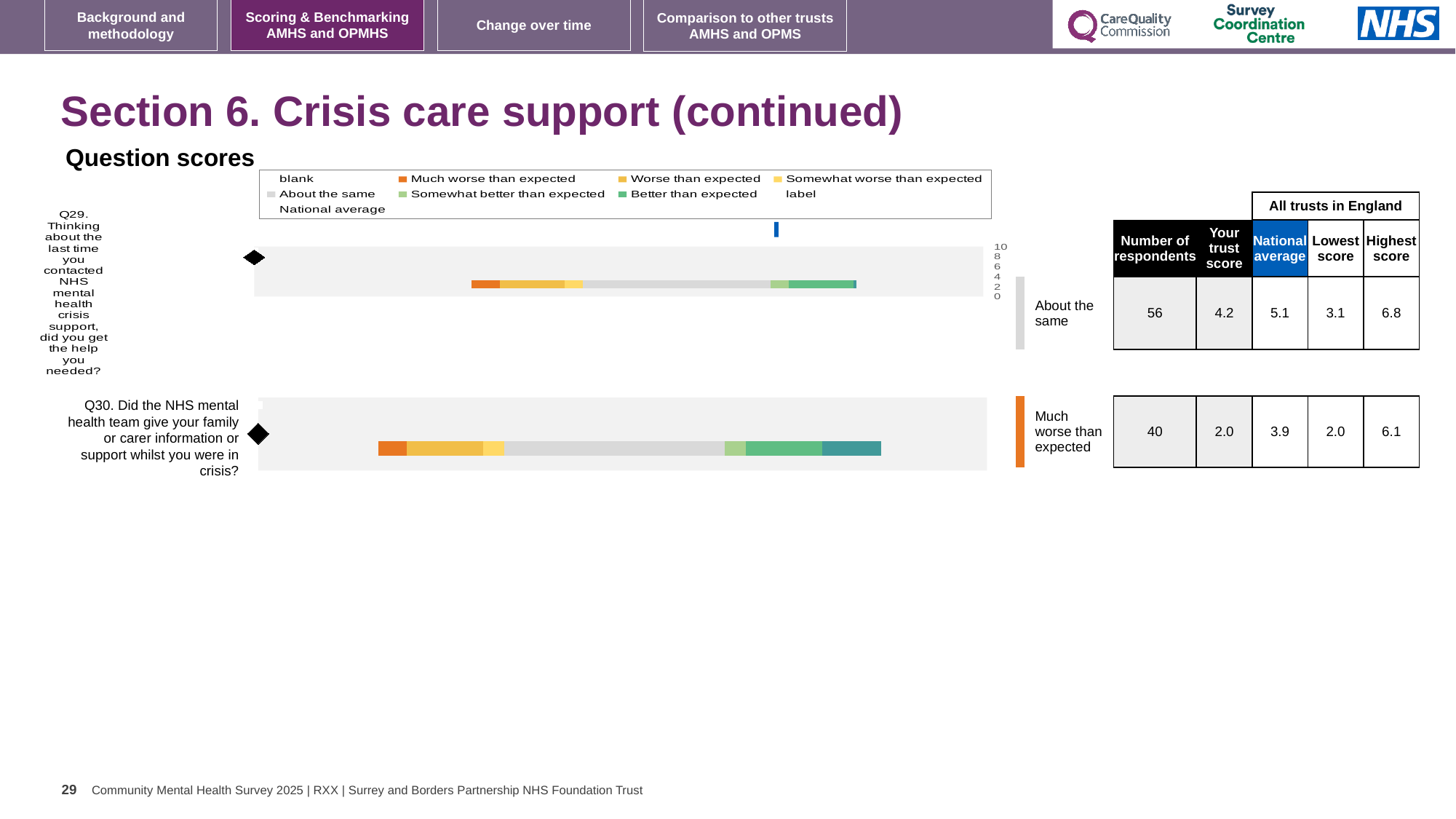
How many questions are plotted in the question scores chart? 2 What kind of chart is used to show the question scores on this slide? bar chart What is the trust score for Q30 in the question scores chart? 2.0 Which question has more respondents, Q29 or Q30? Q29 What is the national average for Q29? 5.1 What is the difference between the national average and the trust score for Q29? 0.9 What is the trust score for Q29 in the question scores chart? 4.2 How many respondents answered Q30? 40 What is the national average for Q30? 3.9 What is the difference between the national average and the trust score for Q30? 1.9 Which benchmark category is Q30 placed in? Much worse than expected What is the highest score across all trusts in England for Q29? 6.8